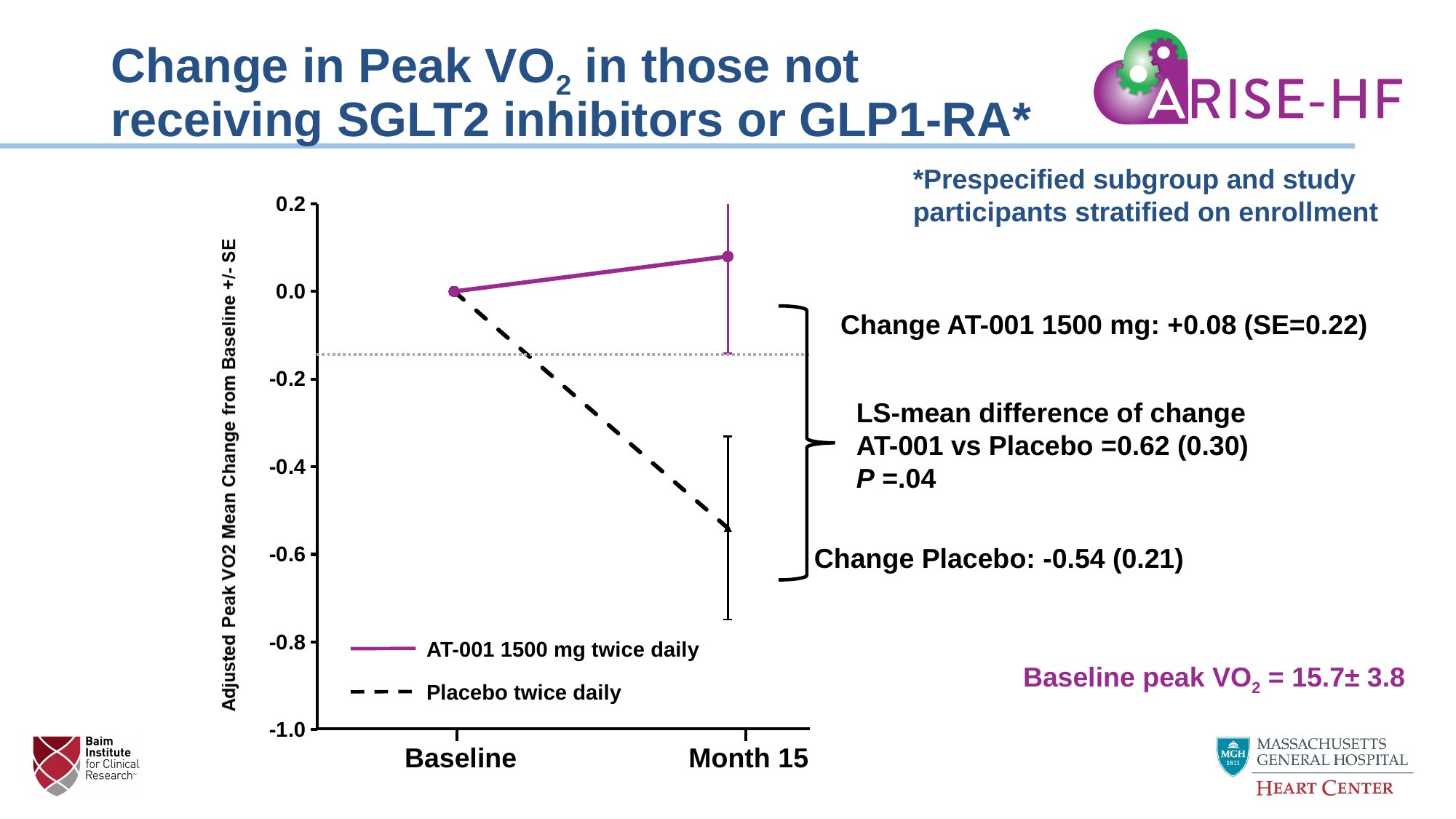
Is the Placebo value at Month 15 greater or less than -0.4? less Which series has the higher value at Month 15, AT-001 1500 mg twice daily or Placebo twice daily? AT-001 1500 mg twice daily What is the change in peak VO2 at Month 15 for AT-001 1500 mg? +0.08 What is the LS-mean difference of change between AT-001 and Placebo? 0.62 What kind of chart is shown on the slide? line chart How many series does the legend list? 2 How many time points are shown on the x axis? 2 What is the standard error of the change for AT-001 1500 mg? 0.22 What is the P value shown for the difference between AT-001 and Placebo? .04 Does the Placebo line rise or fall from Baseline to Month 15? fall What is the change in peak VO2 at Month 15 for Placebo? -0.54 Does the AT-001 1500 mg line rise or fall from Baseline to Month 15? rise